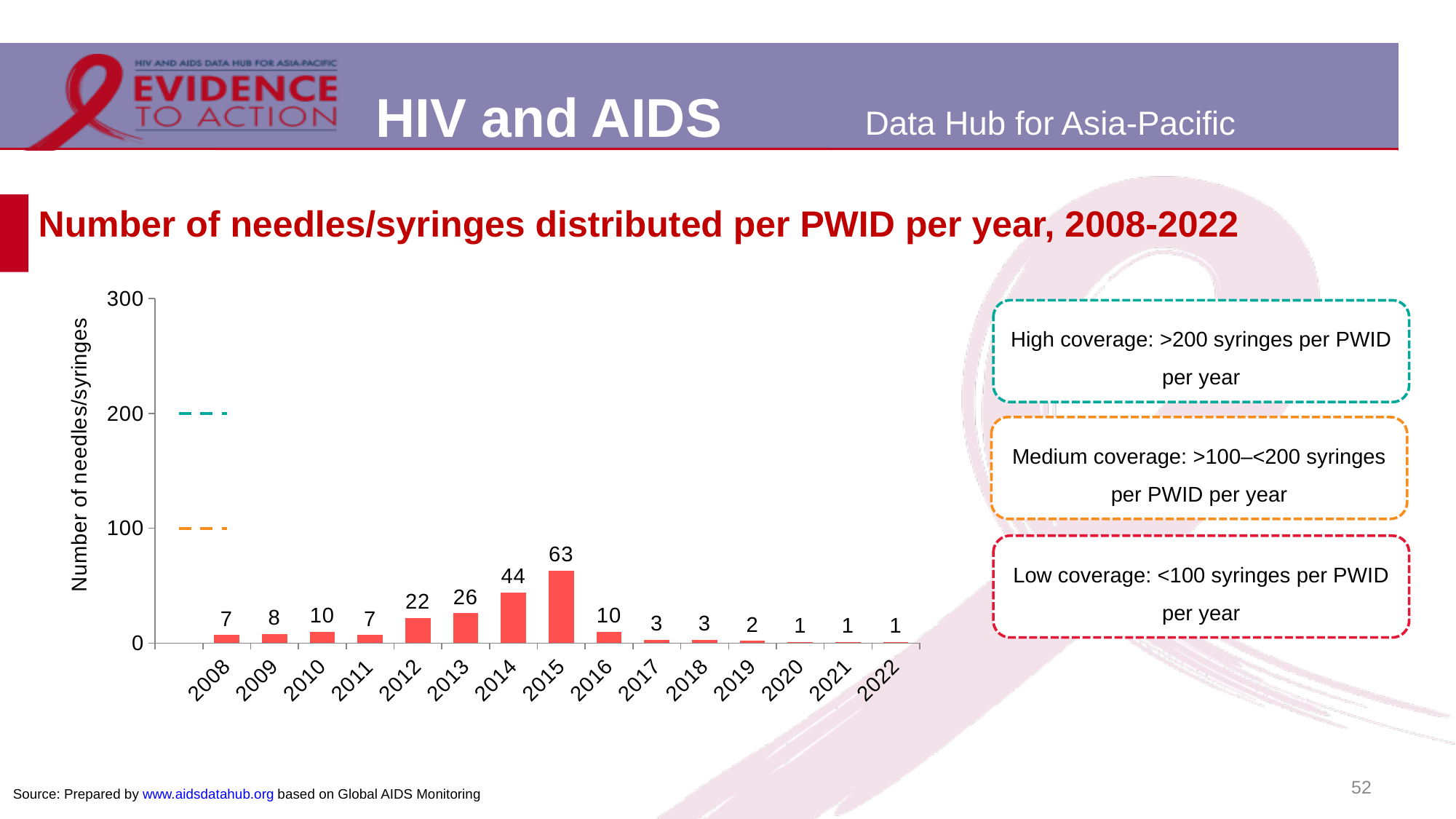
Do the values rise or fall from 2015 to 2022? fall What is the title of the chart? Number of needles/syringes distributed per PWID per year, 2008-2022 What is the number of needles/syringes distributed per PWID in 2015? 63 Which year has the larger value, 2013 or 2016? 2013 What is the difference between the values for 2015 and 2014? 19 What is the number of needles/syringes distributed per PWID in 2012? 22 What is the label of the y axis? Number of needles/syringes Which year has the highest number of needles/syringes distributed per PWID? 2015 What kind of chart is shown on the slide? bar chart How many years are shown on the x axis of the chart? 15 What is the number of needles/syringes distributed per PWID in 2022? 1 Is the value for 2015 greater or less than 100? less